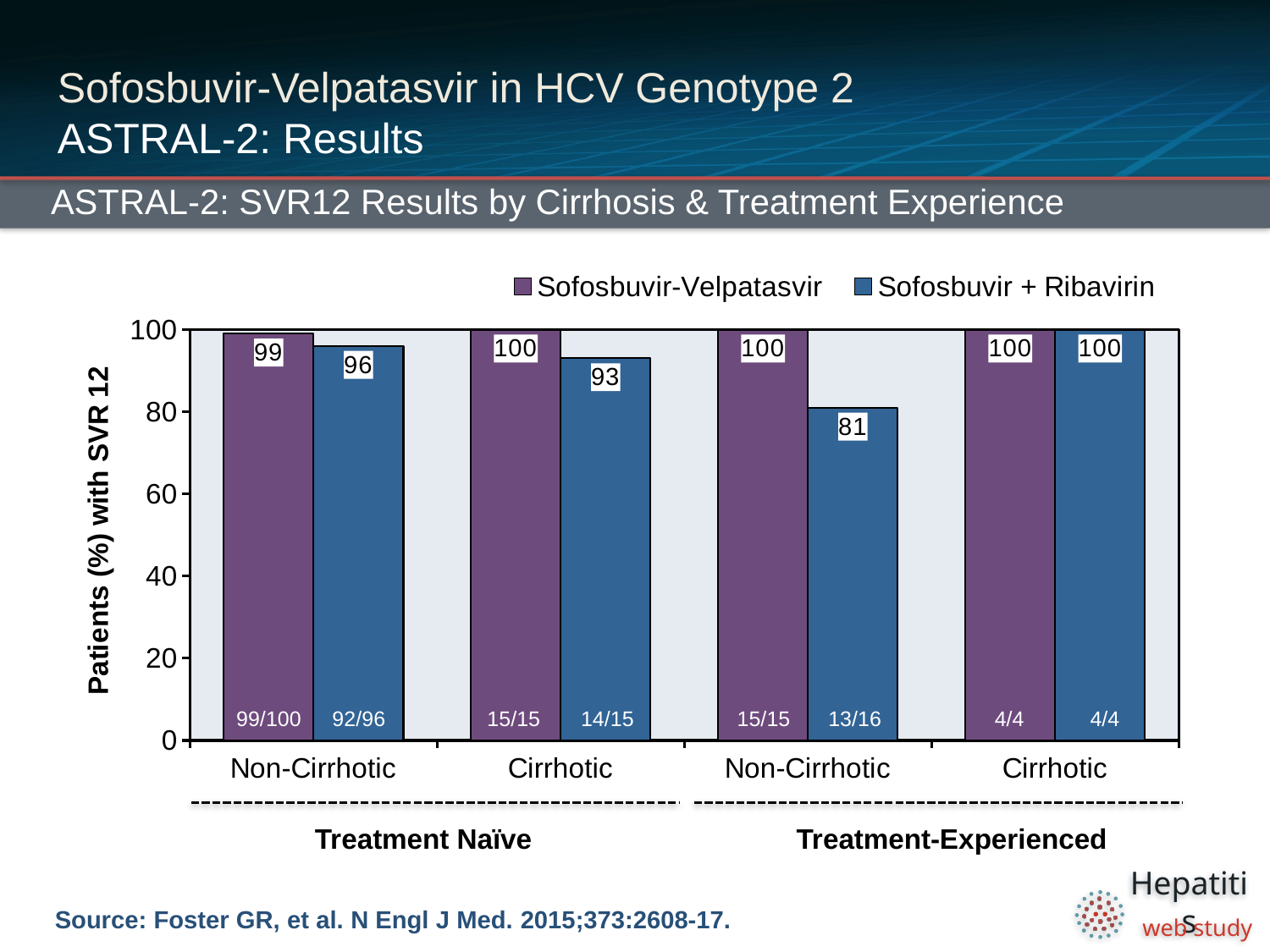
What is the difference between the Sofosbuvir-Velpatasvir and Sofosbuvir + Ribavirin SVR12 rates in treatment-naïve cirrhotic patients? 7 How many series does the legend list? 2 Which bar shows the lowest SVR12 rate on the chart? Sofosbuvir + Ribavirin, treatment-experienced non-cirrhotic What is the difference between the Sofosbuvir-Velpatasvir and Sofosbuvir + Ribavirin SVR12 rates in treatment-experienced non-cirrhotic patients? 19 What fraction of patients is shown for Sofosbuvir + Ribavirin in treatment-naïve non-cirrhotic patients? 92/96 What kind of chart is shown on the slide? Bar chart What is the label of the y axis? Patients (%) with SVR 12 What is the SVR12 rate for Sofosbuvir + Ribavirin in treatment-experienced non-cirrhotic patients? 81 How many patient categories are shown along the x axis? 4 What is the SVR12 rate for Sofosbuvir-Velpatasvir in treatment-naïve non-cirrhotic patients? 99 In treatment-naïve non-cirrhotic patients, which treatment has the higher SVR12 rate? Sofosbuvir-Velpatasvir What is the SVR12 rate for Sofosbuvir + Ribavirin in treatment-naïve cirrhotic patients? 93